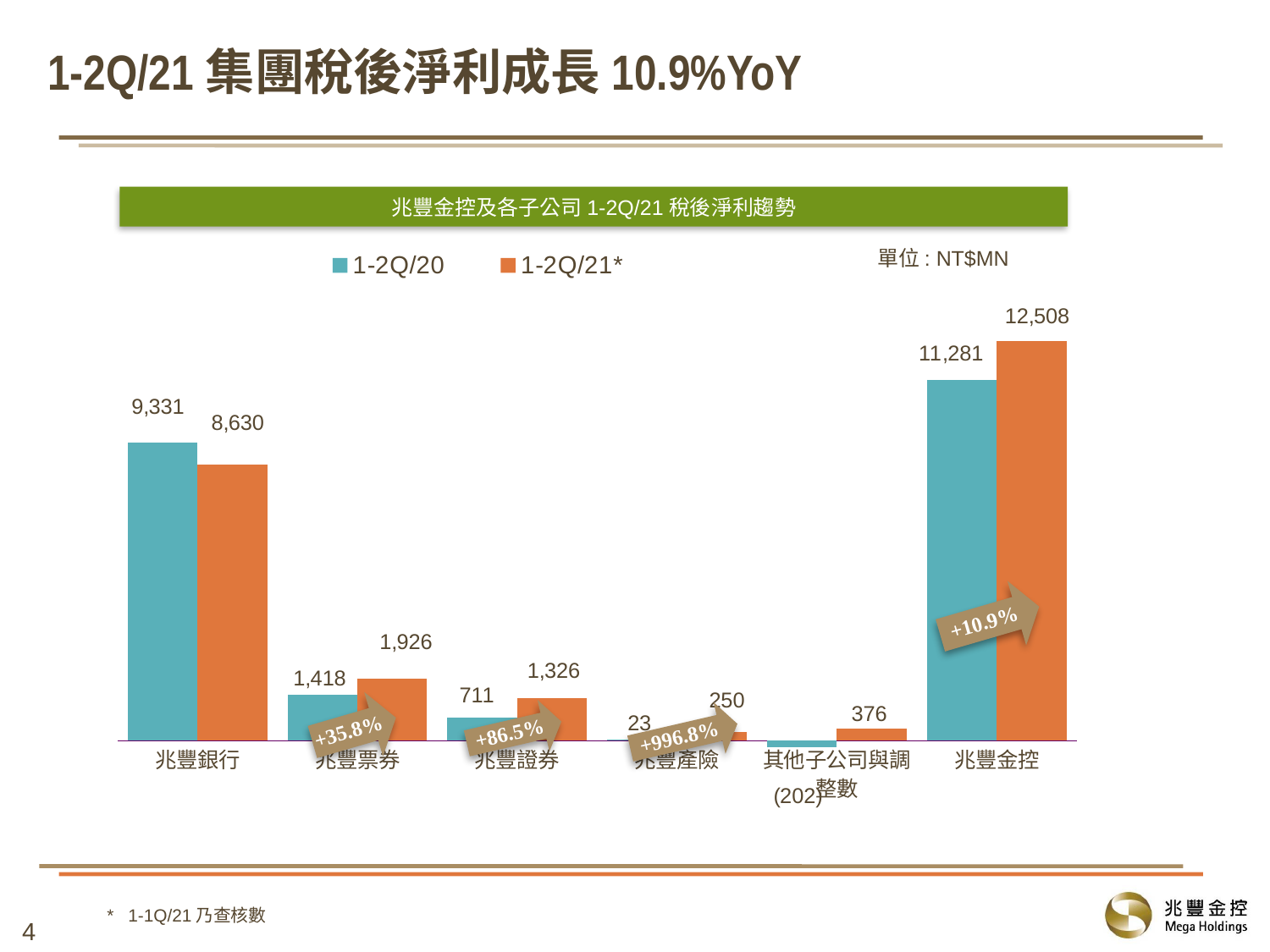
What is the 1-2Q/20 value for 兆豐產險? 23 What is the difference between the 1-2Q/20 and 1-2Q/21* values for 兆豐銀行? 701 What is the difference between the 1-2Q/21* and 1-2Q/20 values for 兆豐金控? 1,227 How many series does the legend list? 2 What is the 1-2Q/21* value for 兆豐銀行? 8,630 What is the 1-2Q/21* value for 兆豐金控? 12,508 Which is larger for 兆豐銀行, the 1-2Q/20 value or the 1-2Q/21* value? 1-2Q/20 What is the 1-2Q/20 value for 兆豐票券? 1,418 What unit is stated for the chart values? NT$MN Which category has the highest 1-2Q/21* value? 兆豐金控 What kind of chart is shown on the slide? bar chart What is the 1-2Q/21* value for 兆豐證券? 1,326